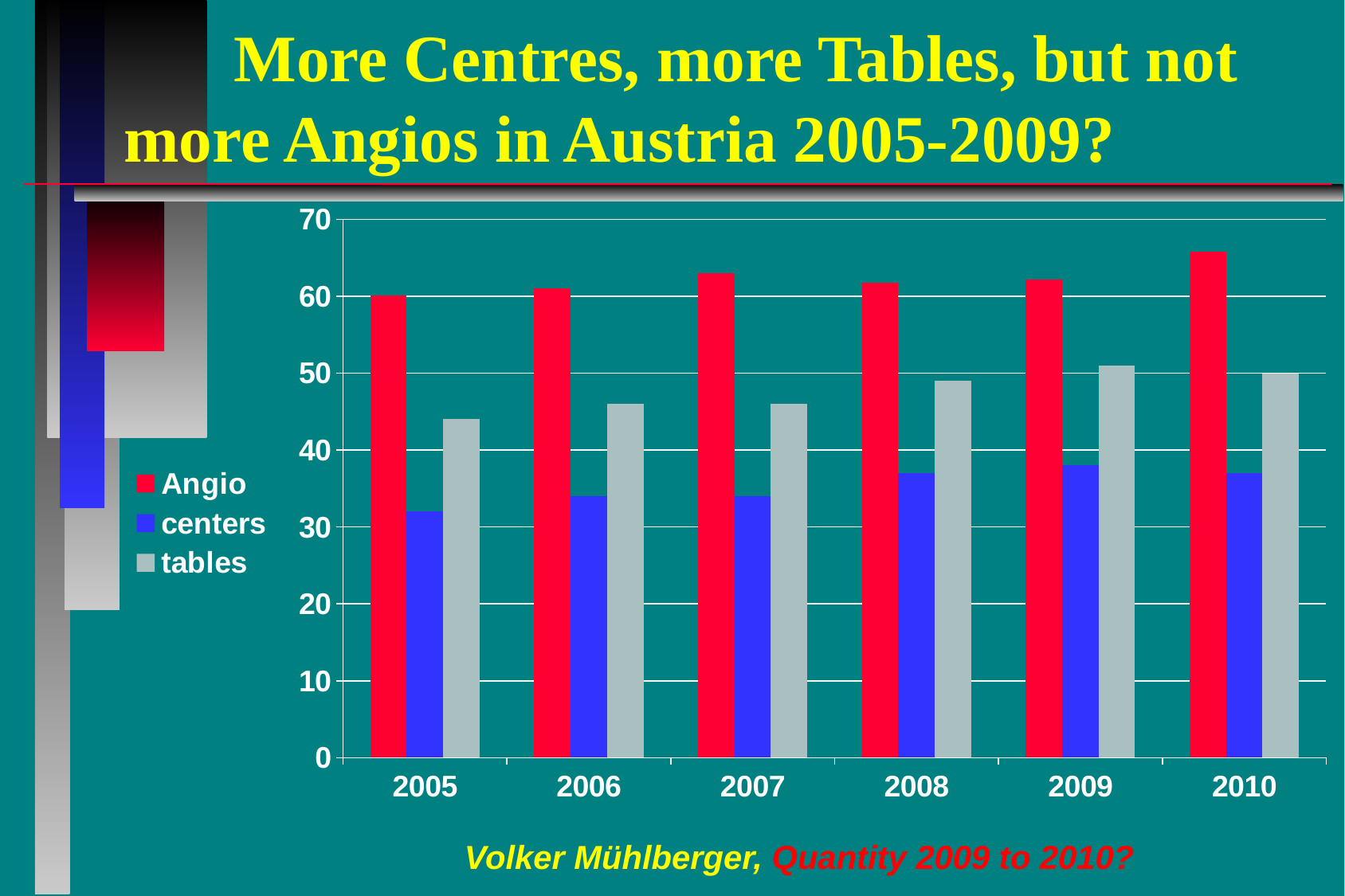
How many years are shown on the x axis? 6 Is the Angio value for 2010 greater or less than 60? greater Do the tables values generally rise or fall from 2005 to 2009? rise What kind of chart is shown on the slide? bar chart In which year is the Angio value highest? 2010 In 2009, which is larger: the tables value or the centers value? tables How many series does the legend list? 3 In which year is the centers value lowest? 2005 Is the centers value for 2009 greater or less than 40? less What colour are the Angio bars? red Is the centers value for 2005 greater or less than 30? greater